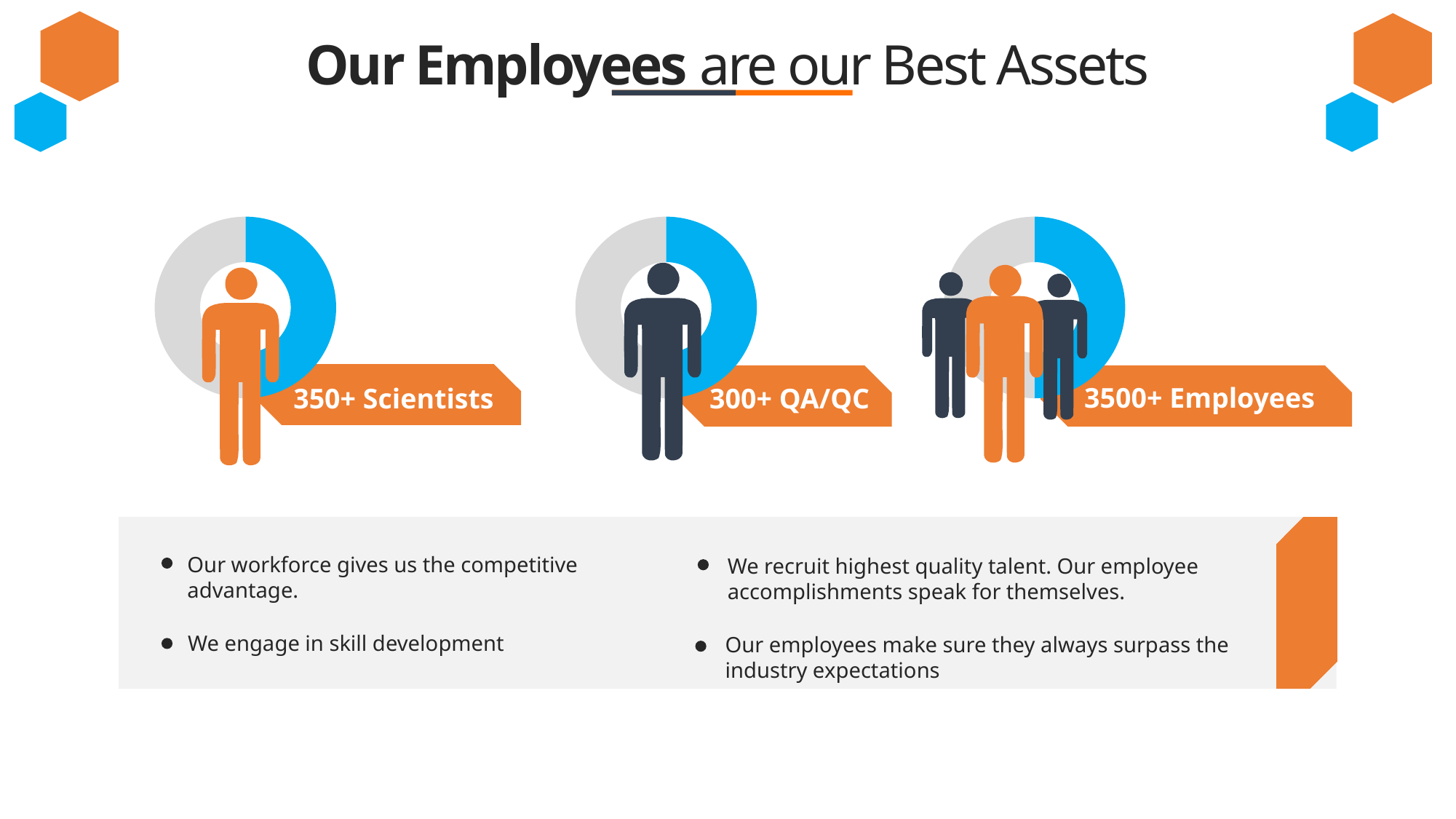
What label is shown on the leftmost donut chart? 350+ Scientists Which is larger, the number of Scientists or the number of QA/QC staff? Scientists Which of the three labelled groups has the largest number? 3500+ Employees How many donut charts are shown on the slide? 3 What label is shown on the middle donut chart? 300+ QA/QC What two colours make up each donut ring on the slide? Blue and grey What label is shown on the rightmost donut chart? 3500+ Employees Which of the three labelled groups has the smallest number? 300+ QA/QC How many QA/QC staff does the slide report? 300+ How many scientists does the slide report? 350+ What kind of chart is used for each of the three figures on the slide? Donut chart How many employees in total does the slide report? 3500+